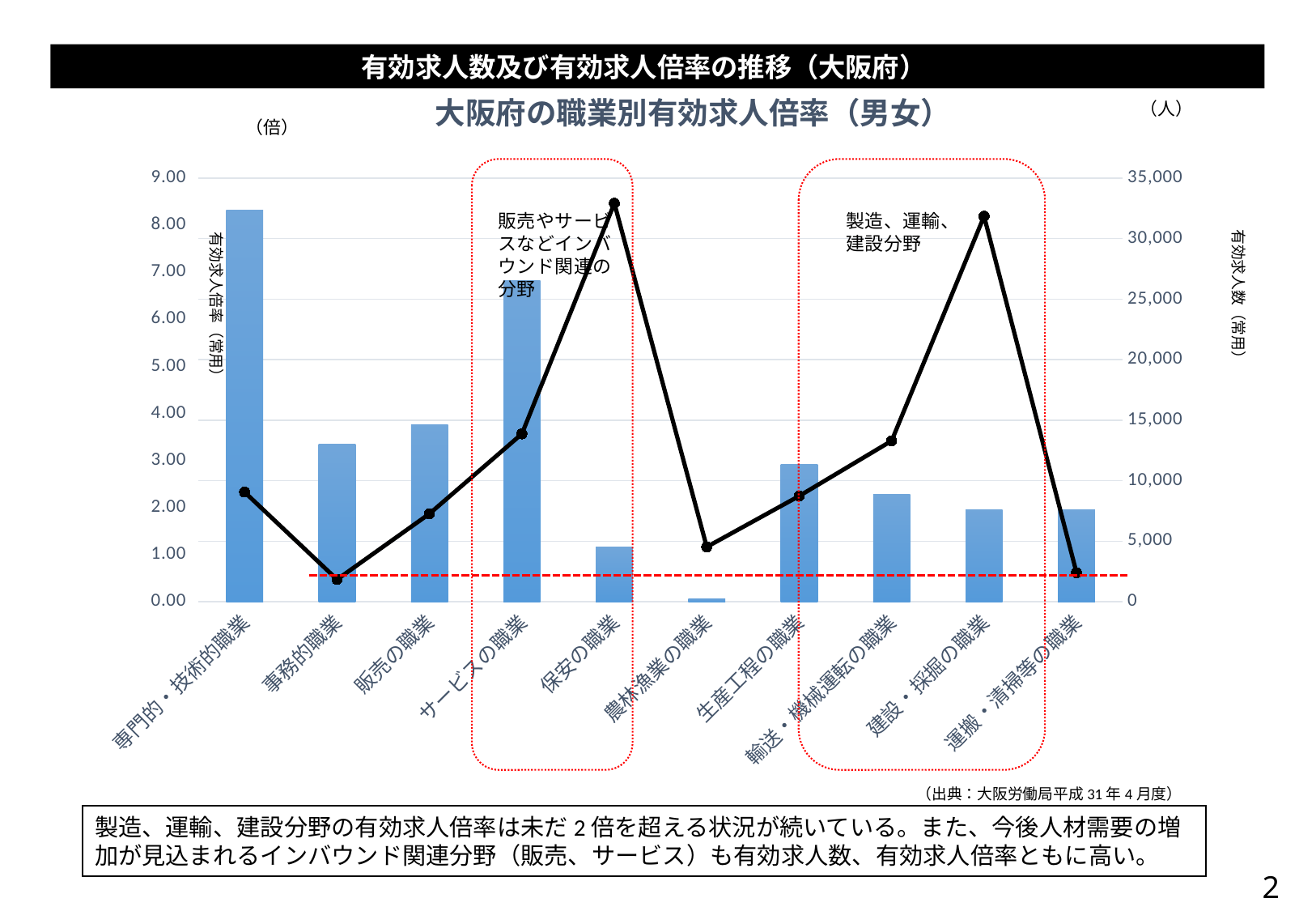
What kind of chart is this? Combined bar and line chart How many occupation categories are shown on the x axis? 10 Which has the larger line value (有効求人数), サービスの職業 or 農林漁業の職業? サービスの職業 Which has the larger bar value, 販売の職業 or 事務的職業? 販売の職業 What is the title of the chart? 大阪府の職業別有効求人倍率（男女）